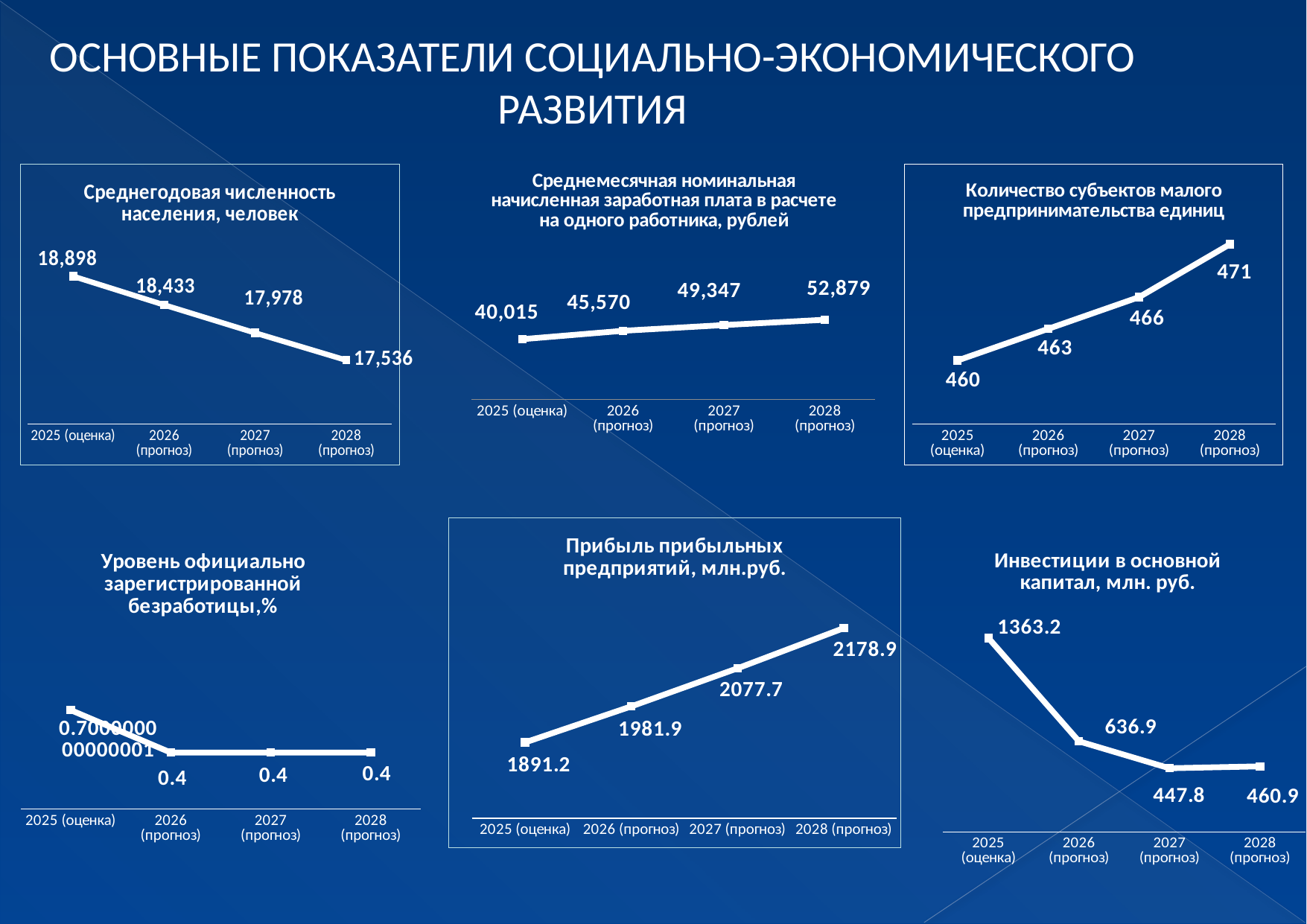
In the chart 'Среднемесячная номинальная начисленная заработная плата в расчете на одного работника, рублей', which year has the highest value? 2028 (прогноз) In the chart 'Прибыль прибыльных предприятий, млн.руб.', how many data points are plotted? 4 In the chart 'Среднегодовая численность населения, человек', what is the value for 2028 (прогноз)? 17,536 In the chart 'Инвестиции в основной капитал, млн. руб.', which year has the lowest value? 2027 (прогноз) In the chart 'Среднемесячная номинальная начисленная заработная плата в расчете на одного работника, рублей', what is the value for 2026 (прогноз)? 45,570 What type of chart is 'Инвестиции в основной капитал, млн. руб.'? line chart In the chart 'Прибыль прибыльных предприятий, млн.руб.', what is the value for 2025 (оценка)? 1891.2 In the chart 'Количество субъектов малого предпринимательства единиц', what is the value for 2027 (прогноз)? 466 In the chart 'Уровень официально зарегистрированной безработицы,%', what is the value for 2027 (прогноз)? 0.4 In the chart 'Количество субъектов малого предпринимательства единиц', what is the difference between the 2028 (прогноз) and 2025 (оценка) values? 11 In the chart 'Среднегодовая численность населения, человек', do the values rise or fall from 2025 to 2028? fall In the chart 'Инвестиции в основной капитал, млн. руб.', which is larger: the value for 2025 (оценка) or 2026 (прогноз)? 2025 (оценка)